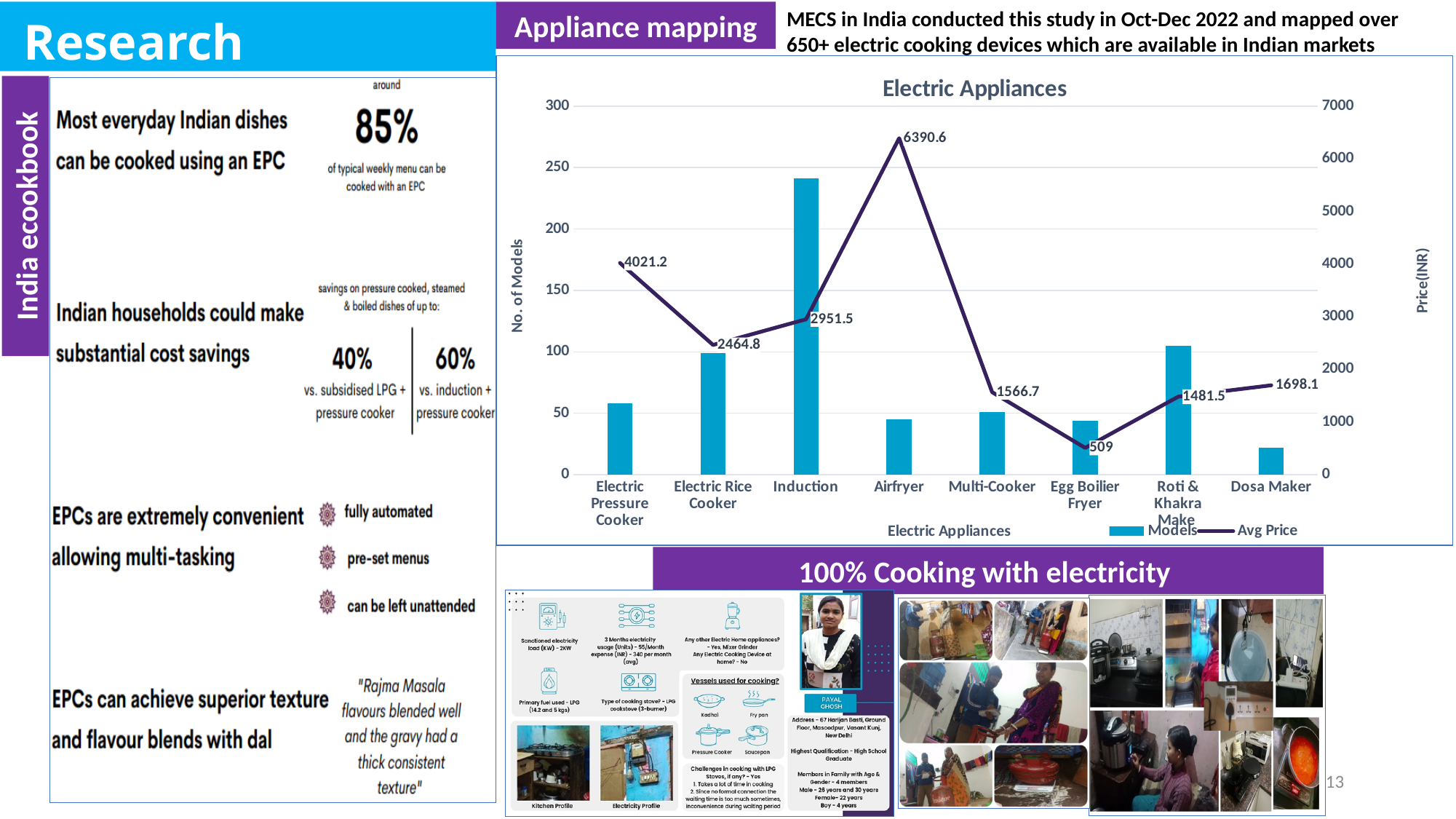
What is the average price shown for the Airfryer in the Electric Appliances chart? 6390.6 What is the average price shown for the Egg Boilier Fryer in the Electric Appliances chart? 509 Is the number of models for Dosa Maker greater or less than 50 in the Electric Appliances chart? less How many appliance categories are shown on the x axis of the Electric Appliances chart? 8 Which appliance has the highest average price in the Electric Appliances chart? Airfryer What is the average price shown for the Electric Pressure Cooker in the Electric Appliances chart? 4021.2 How many series does the legend of the Electric Appliances chart list? 2 Which has a higher average price in the Electric Appliances chart, Induction or Electric Rice Cooker? Induction Which appliance has the lowest average price in the Electric Appliances chart? Egg Boilier Fryer What is the difference between the average price of the Airfryer and the Electric Pressure Cooker in the Electric Appliances chart? 2369.4 Is the number of models for Induction greater or less than 200 in the Electric Appliances chart? greater Which appliance has the highest number of models in the Electric Appliances chart? Induction